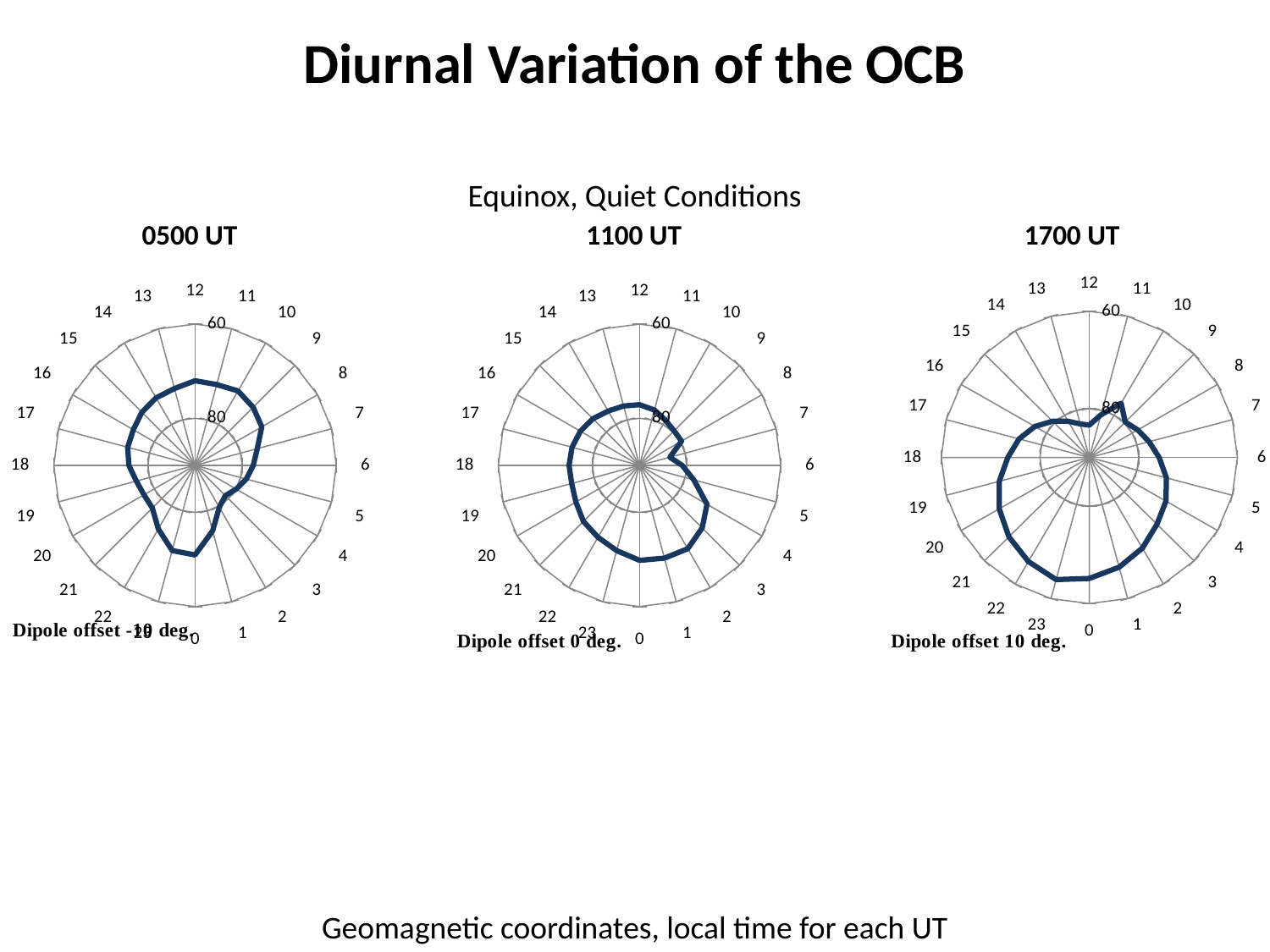
How many local-time categories are plotted around the 1100 UT chart? 24 In the 1700 UT chart, is the value at local time 0 greater or less than 60? greater How many local-time categories are plotted around the 1700 UT chart? 24 What dipole offset is noted under the 1700 UT chart? 10 deg. In the 0500 UT chart, is the value at local time 12 greater or less than 80? less How many charts are shown on the slide? 3 What conditions are the three charts labelled as showing? Equinox, Quiet Conditions In the 1700 UT chart, is the value at local time 0 greater or less than 80? less What kind of chart is the 0500 UT chart? radar chart